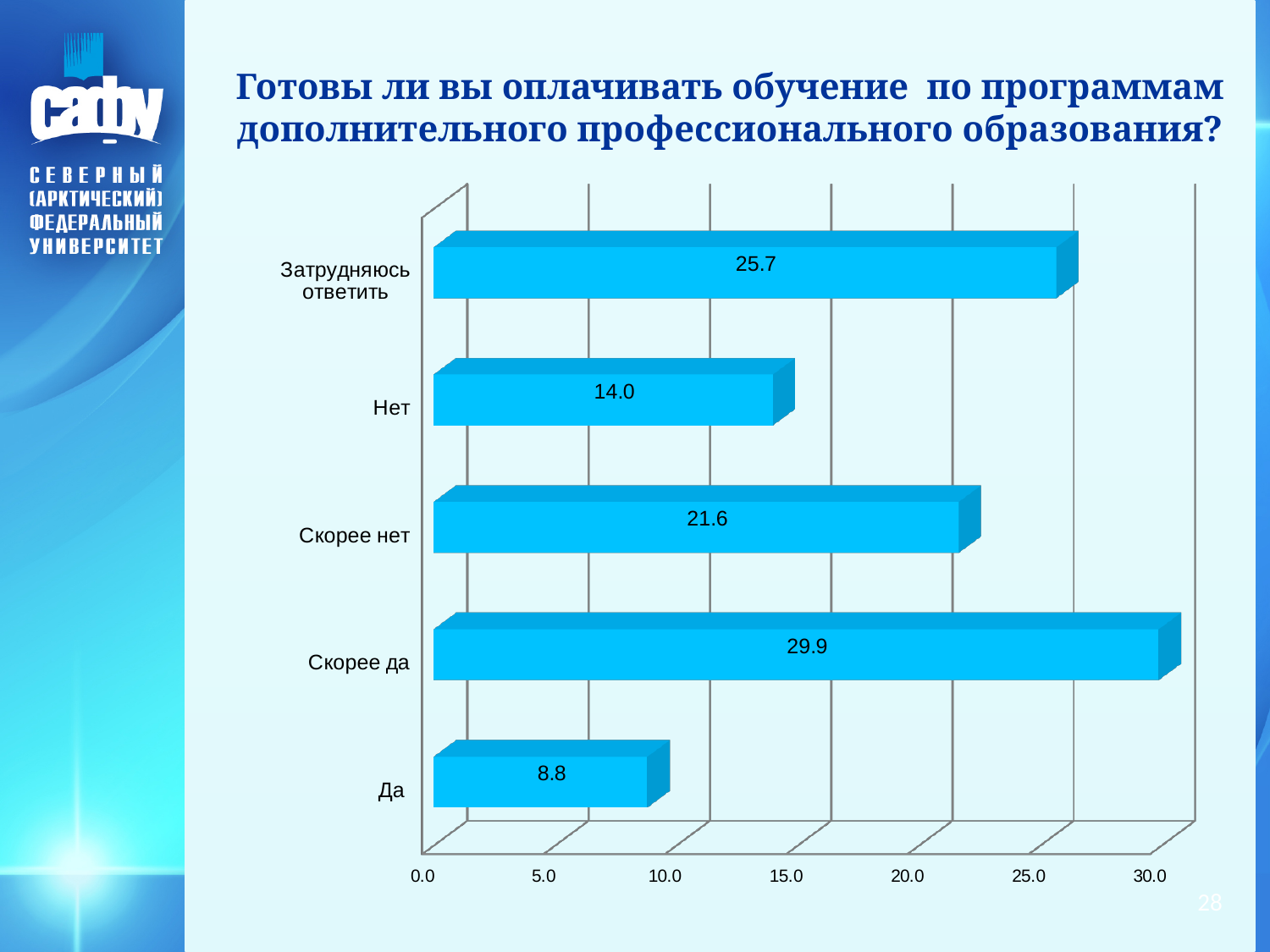
What is the value for "Да"? 8.8 Is the value for "Скорее нет" greater or less than 20.0? greater What is the difference between the values for "Затрудняюсь ответить" and "Скорее нет"? 4.1 Which is larger, the value for "Скорее нет" or the value for "Нет"? Скорее нет Which category has the highest value? Скорее да What is the difference between the values for "Скорее да" and "Да"? 21.1 What is the value for "Затрудняюсь ответить"? 25.7 What is the value for "Нет"? 14.0 What is the value for "Скорее да"? 29.9 Which category has the lowest value? Да How many categories are shown in the chart? 5 What kind of chart is shown on the slide? bar chart